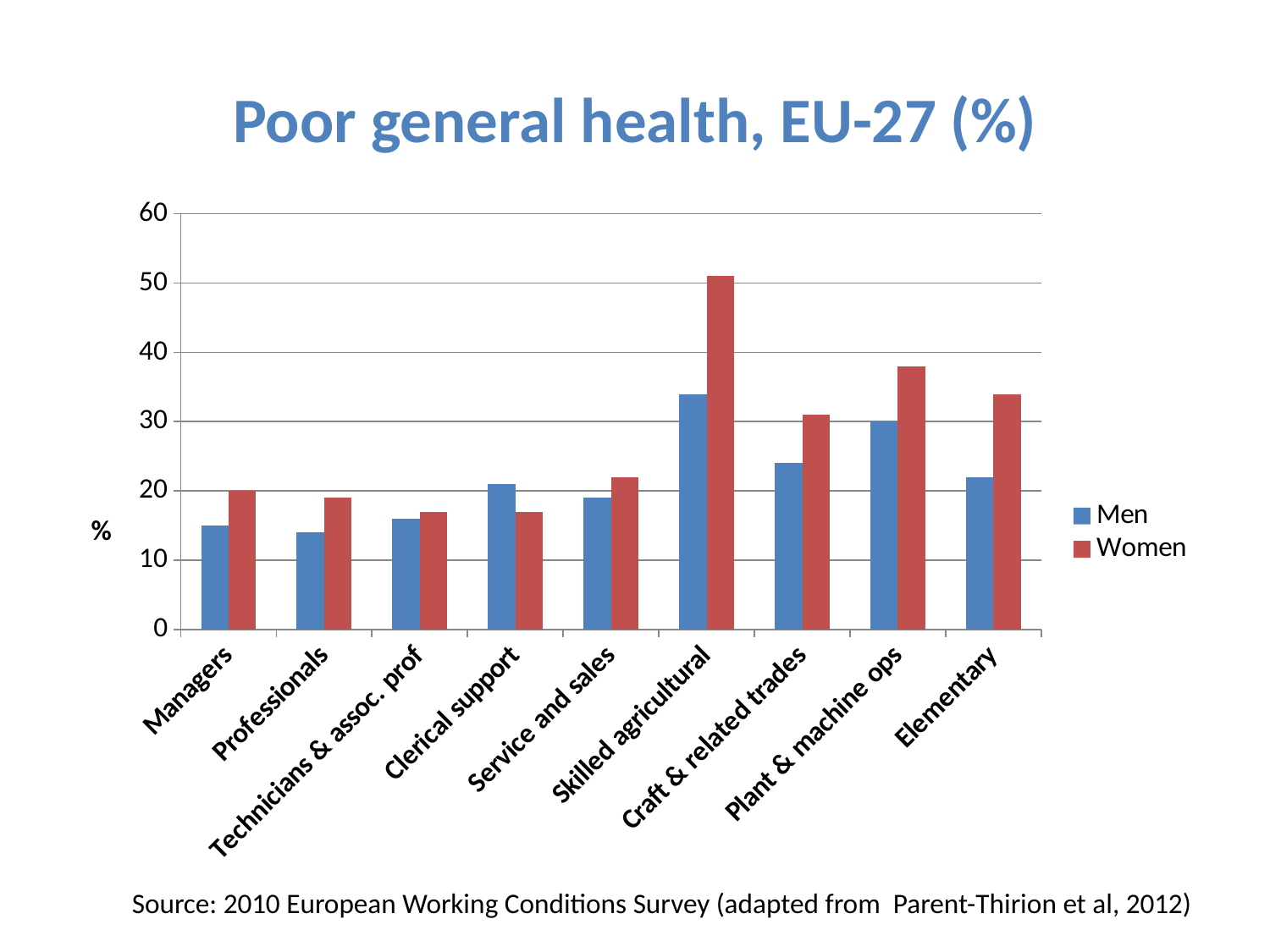
For Clerical support, which is larger, the value for Men or for Women? Men Which category has the highest value for Women? Skilled agricultural What kind of chart is shown on the slide? bar chart Is the value for Men in Managers greater or less than 20? less Which category has the highest value for Men? Skilled agricultural What colour represents the Women series in the chart? red For Managers, which is larger, the value for Men or for Women? Women How many occupational categories are shown on the x axis? 9 Is the value for Men in Craft & related trades greater or less than 20? greater Is the value for Women in Skilled agricultural greater or less than 40? greater How many series does the legend list? 2